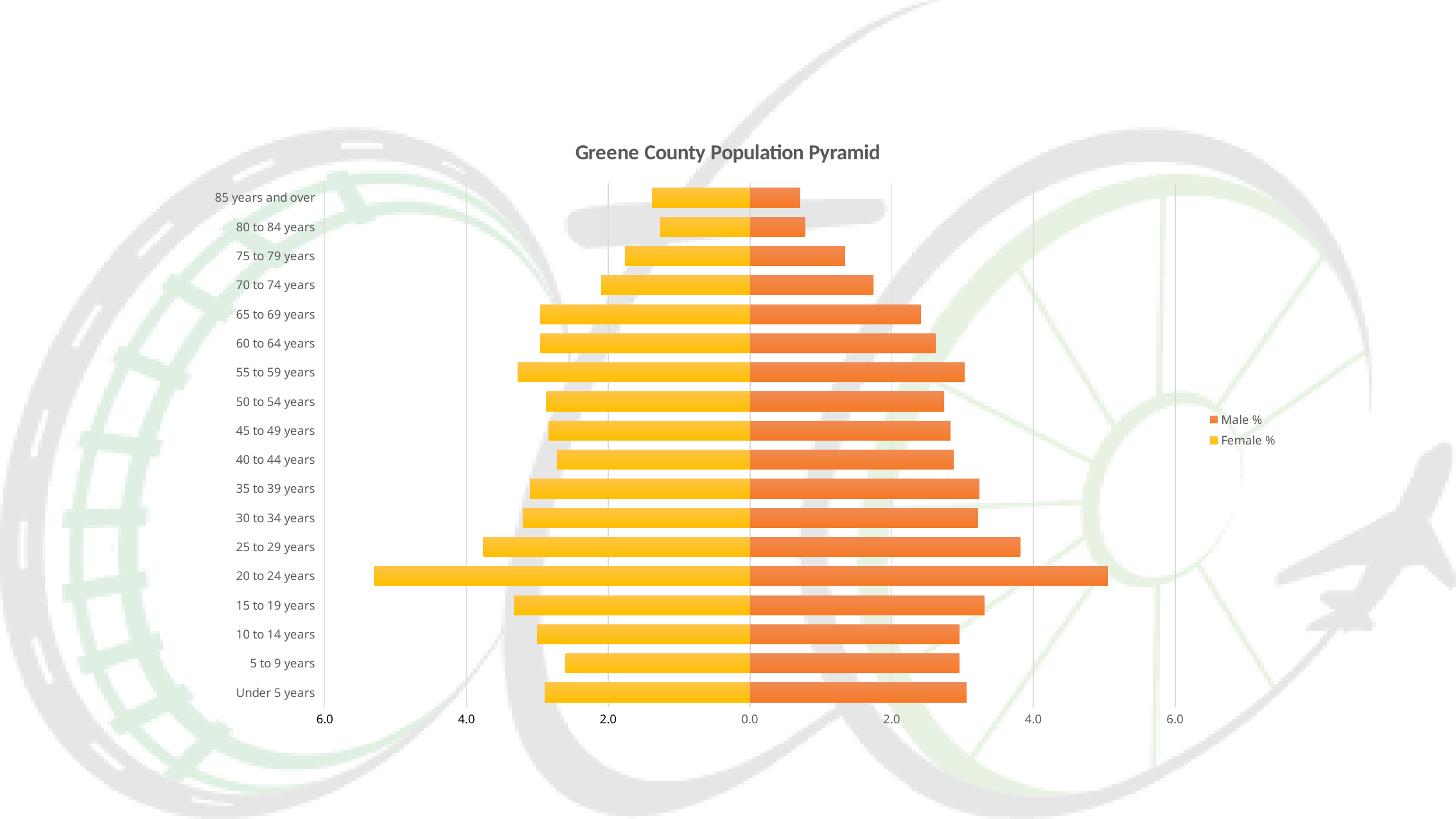
Which age group has the highest Female % value? 20 to 24 years Is the Male % value for 85 years and over greater or less than 2.0? less How many age groups are shown on the vertical axis? 18 How many series does the legend list? 2 What is the title of the chart? Greene County Population Pyramid Is the Male % value for 20 to 24 years greater or less than 4.0? greater Which is larger, the Male % for 20 to 24 years or the Male % for 25 to 29 years? 20 to 24 years Which age group has the highest Male % value? 20 to 24 years Is the Male % value for 65 to 69 years greater or less than 2.0? greater What kind of chart is shown on the slide? bar chart Which colour represents the Female % series? yellow